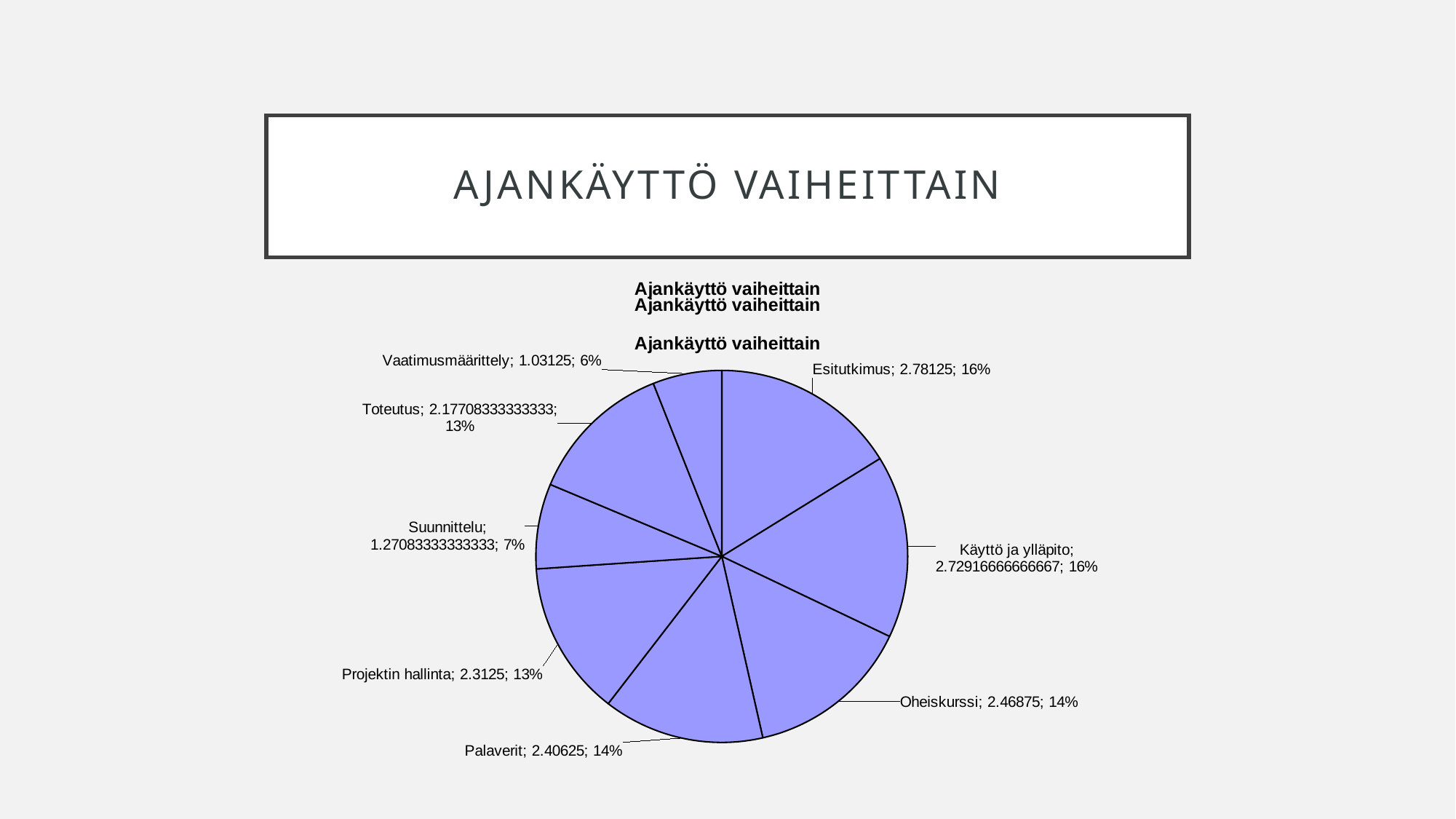
What is the title of the chart? Ajankäyttö vaiheittain What is the difference between the values for Esitutkimus and Vaatimusmäärittely? 1.75 What percentage share of the pie does Toteutus have? 13% What value is shown for Projektin hallinta in the pie chart? 2.3125 Which is larger, the value for Palaverit or the value for Suunnittelu? Palaverit What percentage share of the pie does Suunnittelu have? 7% How many slices does the pie chart have? 8 What value is shown for Oheiskurssi in the pie chart? 2.46875 Which category has the largest value in the pie chart? Esitutkimus Which category has the smallest slice in the pie chart? Vaatimusmäärittely What type of chart is shown on the slide? Pie chart What value is shown for Esitutkimus in the pie chart? 2.78125